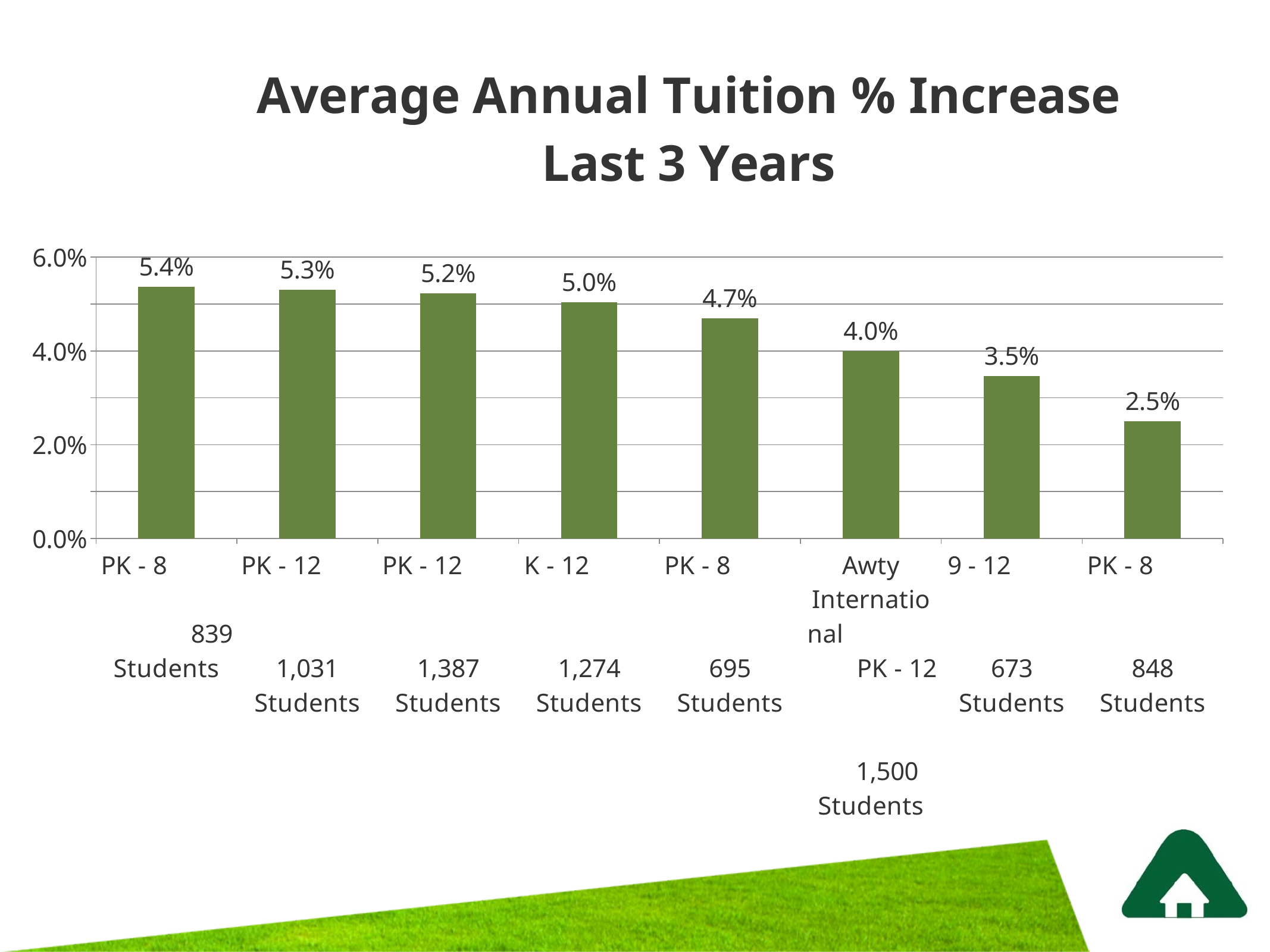
Which has a larger tuition % increase: the PK - 8 school with 695 Students or Awty International? PK - 8, 695 Students What is the average annual tuition % increase for the PK - 12 school with 1,387 Students? 5.2% Do the tuition % increase values rise or fall from left to right across the chart? fall How many schools are shown in the chart? 8 What is the average annual tuition % increase for Awty International (PK - 12, 1,500 Students)? 4.0% Which school has the lowest average annual tuition % increase? PK - 8, 848 Students What is the average annual tuition % increase for the 9 - 12 school with 673 Students? 3.5% What is the average annual tuition % increase for the K - 12 school with 1,274 Students? 5.0% Is the tuition % increase for the 9 - 12 school with 673 Students greater or less than 4.0%? less What is the difference between the tuition % increase of the PK - 8 school with 839 Students and the PK - 8 school with 848 Students? 2.9% What type of chart is shown on the slide? bar chart Which school has the highest average annual tuition % increase? PK - 8, 839 Students